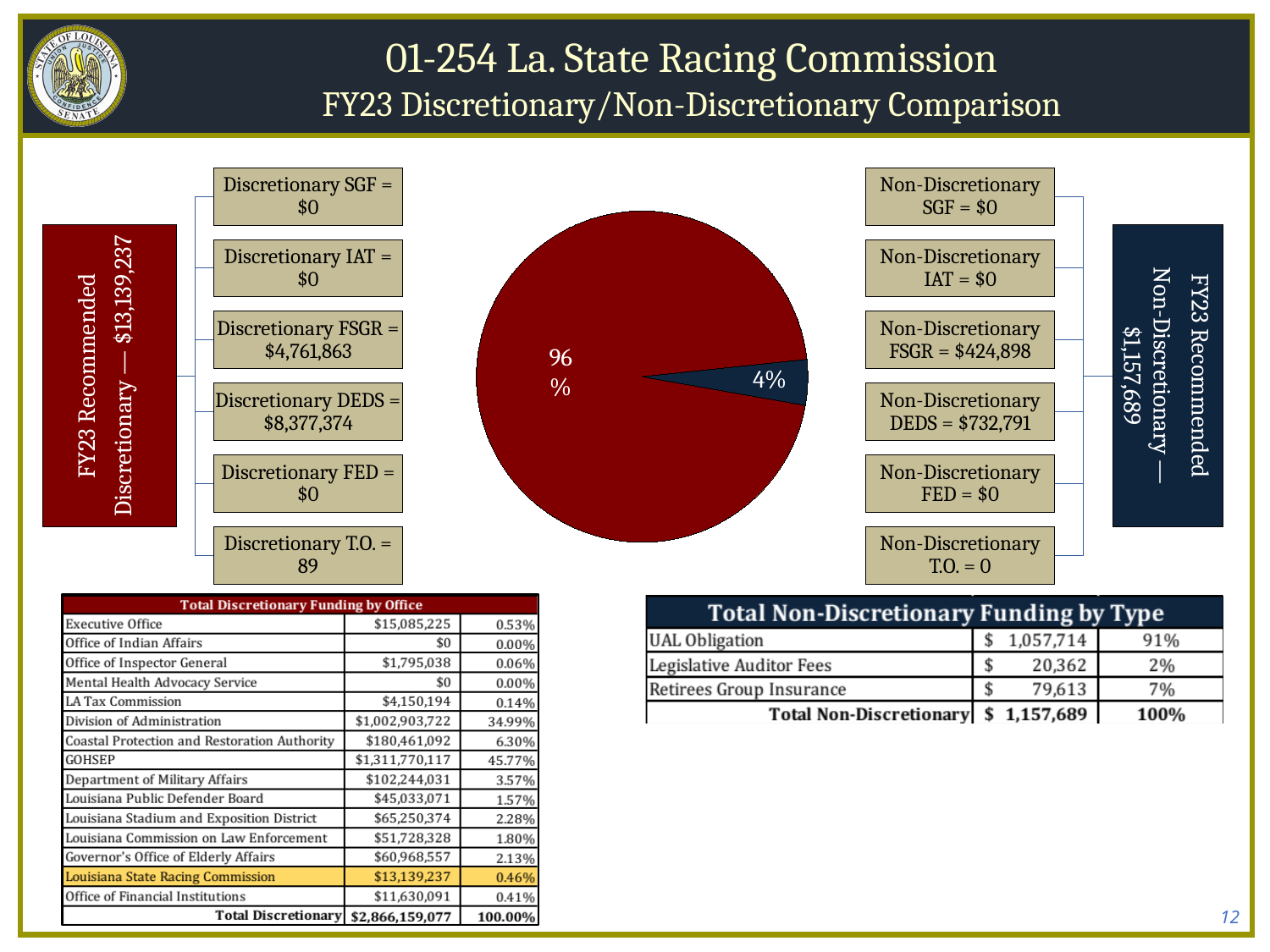
How many slices does the pie chart have? 2 What colour is the slice labelled 4% in the pie chart? dark blue Is the share of the dark blue slice in the pie chart greater or less than 10%? less What share of the pie chart does the large red slice represent? 96% What is the smallest share shown on the pie chart? 4% What share of the pie chart does the small dark blue slice represent? 4% What colour is the slice labelled 96% in the pie chart? red What is the largest share shown on the pie chart? 96% What kind of chart is shown in the centre of the slide? pie chart Which slice of the pie chart is larger, the red slice or the dark blue slice? the red slice What is the difference in percentage points between the two slices of the pie chart? 92